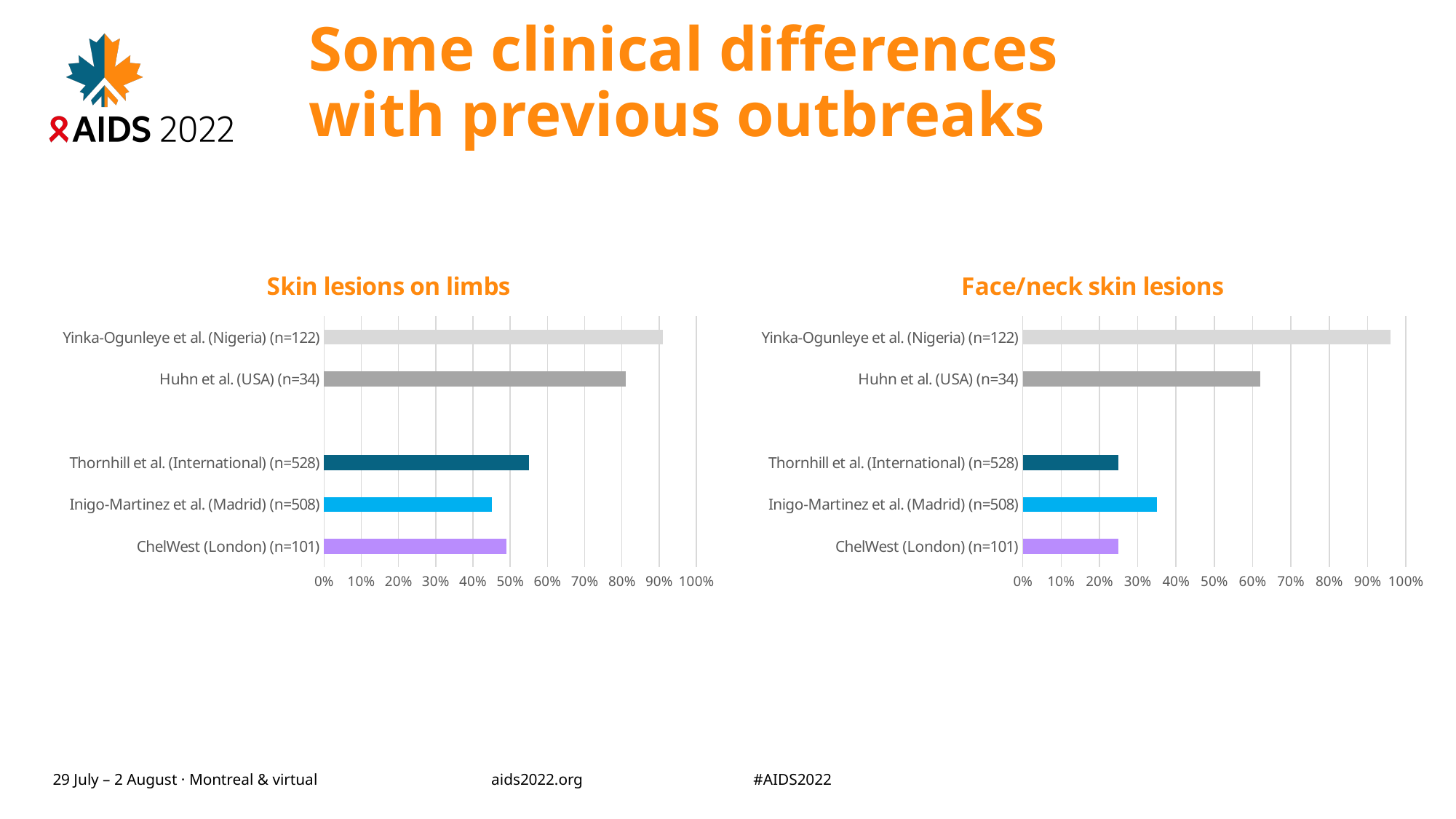
What is the title of the chart on the right side of the slide? Face/neck skin lesions In the 'Skin lesions on limbs' chart, which study has the highest value? Yinka-Ogunleye et al. (Nigeria) (n=122) In the 'Skin lesions on limbs' chart, what colour is the bar for ChelWest (London) (n=101)? purple In the 'Face/neck skin lesions' chart, which study has the highest value? Yinka-Ogunleye et al. (Nigeria) (n=122) In the 'Face/neck skin lesions' chart, is the value for Huhn et al. (USA) (n=34) greater or less than 50%? greater In the 'Face/neck skin lesions' chart, which is larger: the value for Inigo-Martinez et al. (Madrid) (n=508) or for ChelWest (London) (n=101)? Inigo-Martinez et al. (Madrid) (n=508) What kind of chart is the 'Skin lesions on limbs' chart? bar chart In the 'Face/neck skin lesions' chart, is the value for Thornhill et al. (International) (n=528) greater or less than 30%? less In the 'Skin lesions on limbs' chart, is the value for Huhn et al. (USA) (n=34) greater or less than 70%? greater How many studies are plotted in the 'Face/neck skin lesions' chart? 5 In the 'Skin lesions on limbs' chart, which is larger: the value for Thornhill et al. (International) (n=528) or for Inigo-Martinez et al. (Madrid) (n=508)? Thornhill et al. (International) (n=528)